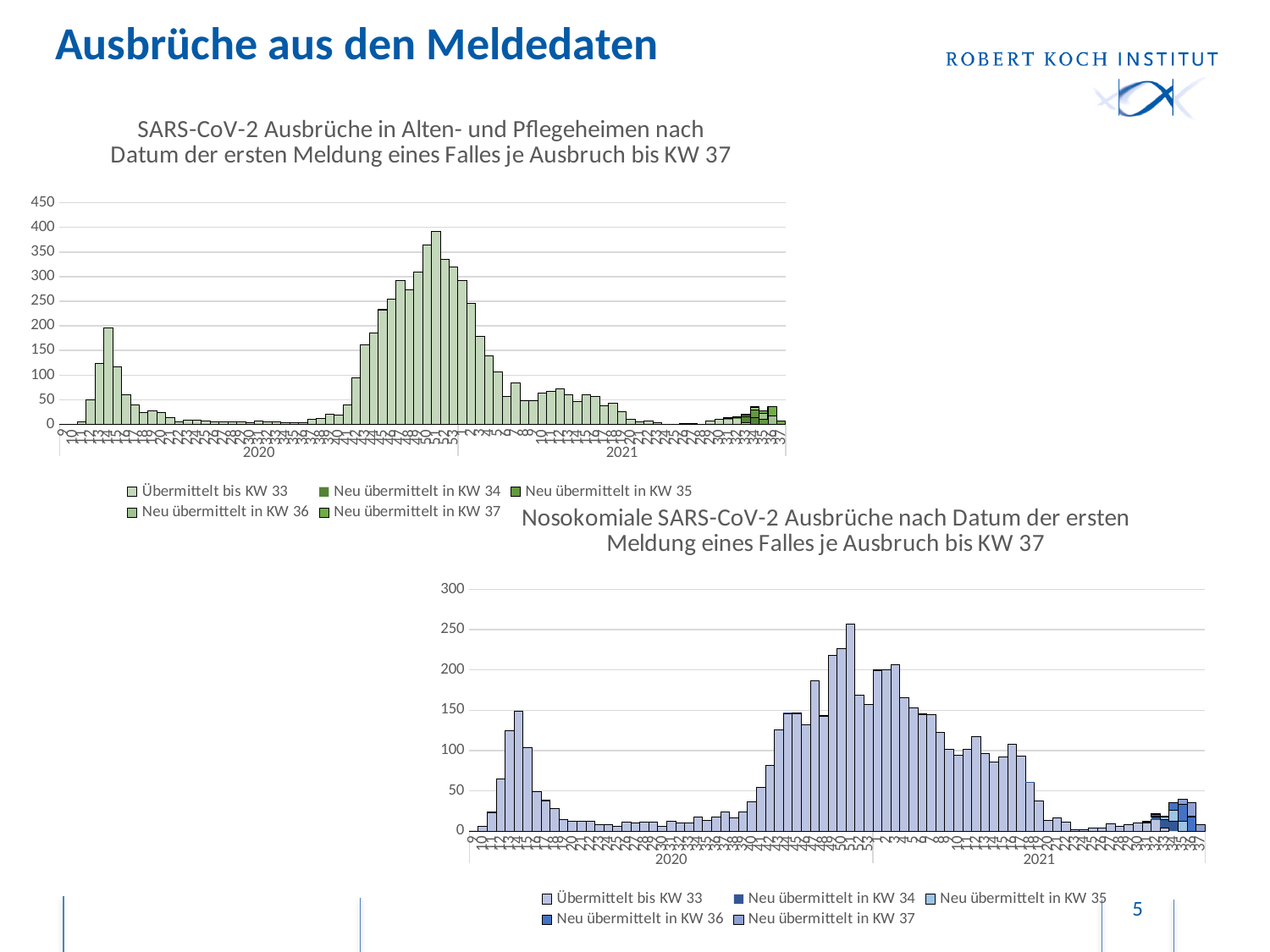
In the bottom chart, is the value of the highest bar greater or less than 200? greater In the top chart, which year contains the highest bar, 2020 or 2021? 2020 In the bottom chart, is the value of the highest bar greater or less than 300? less How many series does the legend of the bottom chart, 'Nosokomiale SARS-CoV-2 Ausbrüche', list? 5 In the top chart, is the value of the highest bar greater or less than 350? greater In the bottom chart, which is larger: the peak in spring 2020 or the peak in late 2020? the peak in late 2020 What kind of chart is the top chart, 'SARS-CoV-2 Ausbrüche in Alten- und Pflegeheimen'? bar chart What is the first legend entry of the top chart? Übermittelt bis KW 33 What is the highest value shown on the y axis of the bottom chart? 300 How many series does the legend of the top chart list? 5 In the top chart, which is larger: the peak in spring 2020 or the peak in late 2020? the peak in late 2020